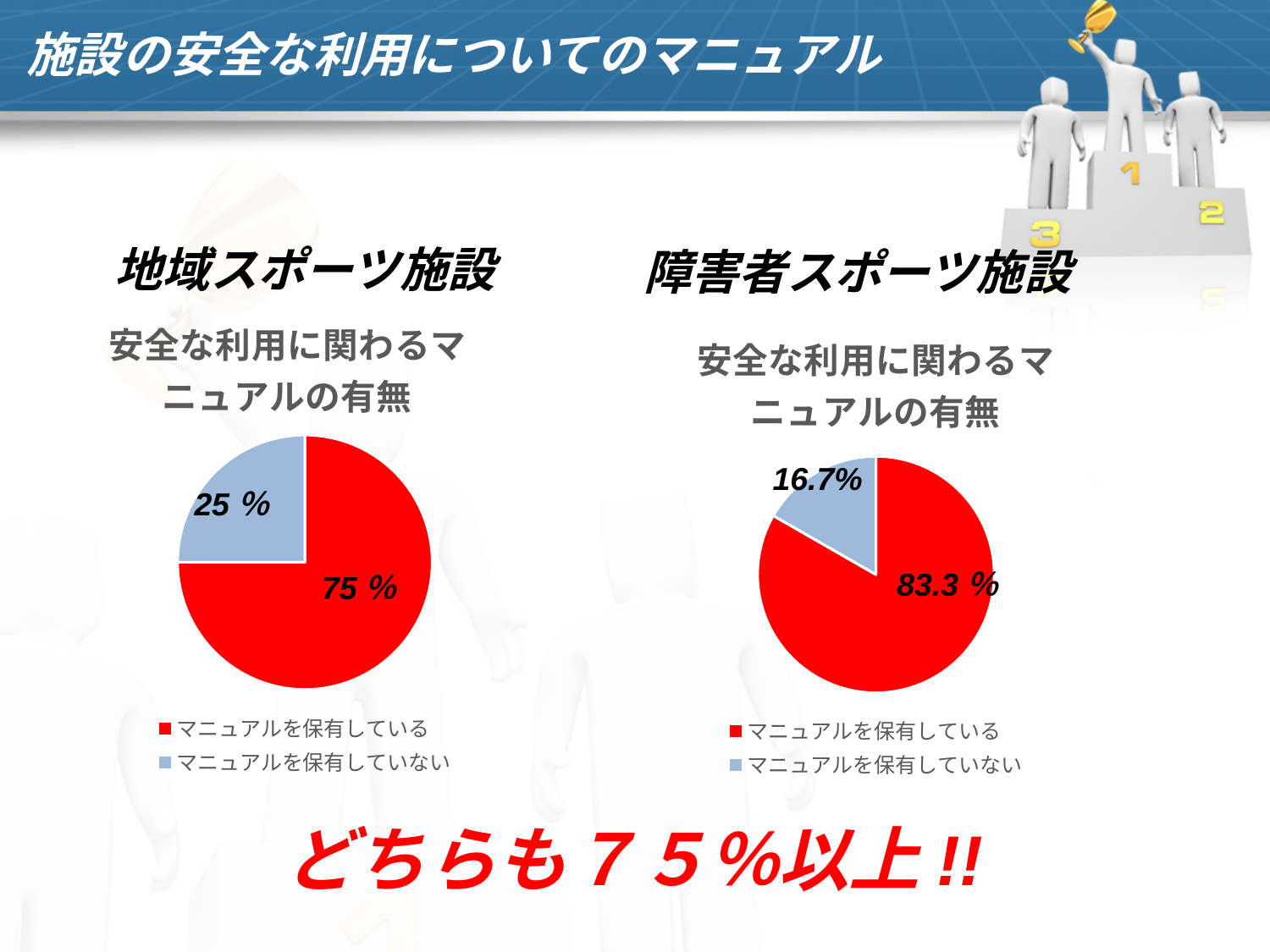
What colour represents マニュアルを保有している in the 障害者スポーツ施設 (right) pie chart? red In the 地域スポーツ施設 (left) pie chart, which slice is the smallest? マニュアルを保有していない What kind of chart is used for the 地域スポーツ施設 (left) chart? pie chart How many slices does the 障害者スポーツ施設 (right) pie chart have? 2 In the 地域スポーツ施設 (left) pie chart, what is the difference between the マニュアルを保有している share and the マニュアルを保有していない share? 50 % Which chart shows a larger share for マニュアルを保有している, the 地域スポーツ施設 (left) chart or the 障害者スポーツ施設 (right) chart? 障害者スポーツ施設 (right) In the 地域スポーツ施設 (left) pie chart, what share is labelled for マニュアルを保有していない? 25 % In the 障害者スポーツ施設 (right) pie chart, which slice is the largest? マニュアルを保有している In the 障害者スポーツ施設 (right) pie chart, what share is labelled for マニュアルを保有していない? 16.7% In the 地域スポーツ施設 (left) pie chart, what share is labelled for マニュアルを保有している? 75 % How many entries does the legend of the 地域スポーツ施設 (left) chart list? 2 In the 障害者スポーツ施設 (right) pie chart, what share is labelled for マニュアルを保有している? 83.3 %